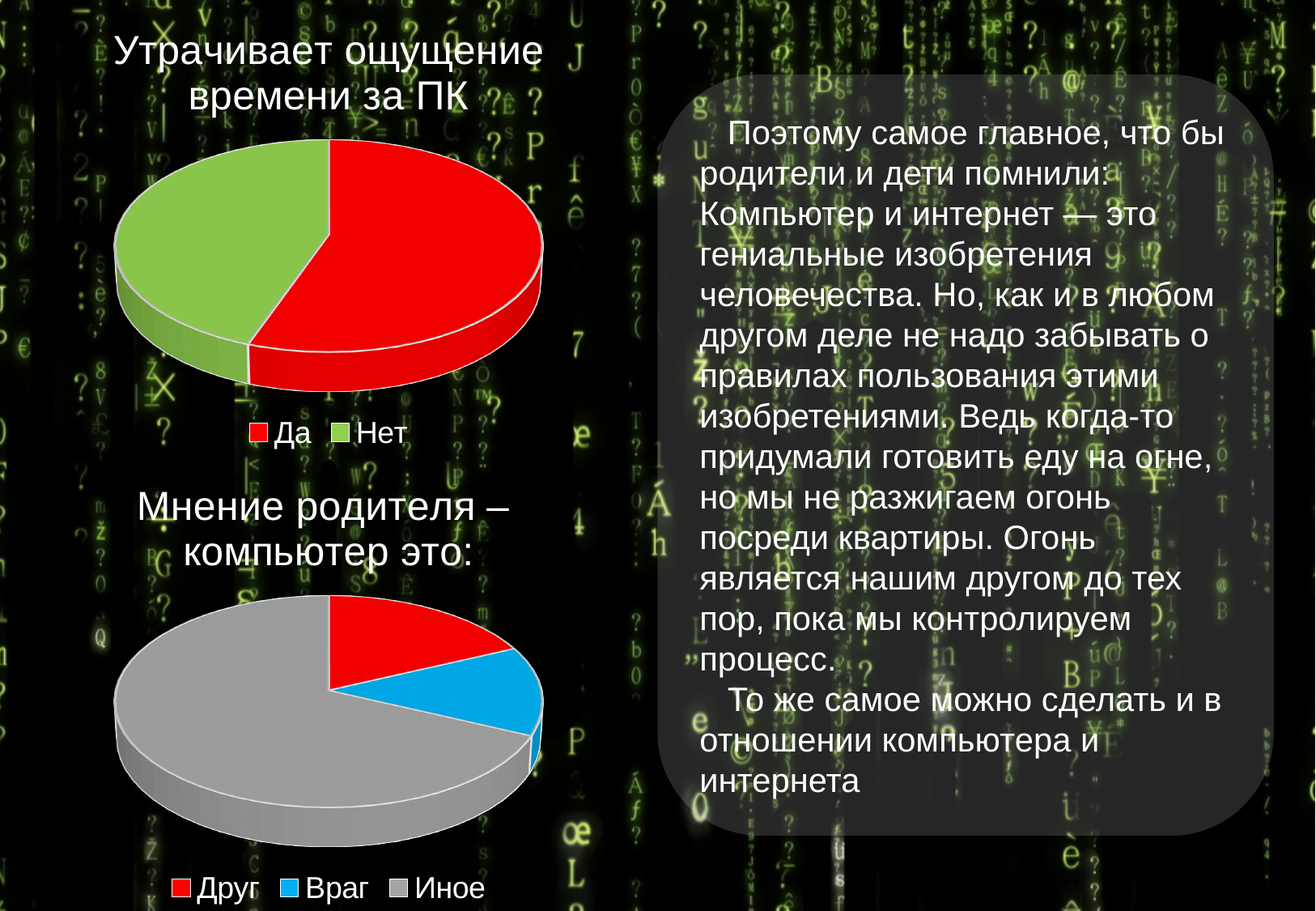
In the top chart "Утрачивает ощущение времени за ПК", which slice is larger: Да or Нет? Да What kind of chart is the bottom chart titled "Мнение родителя – компьютер это:"? Pie chart What kind of chart is the top chart titled "Утрачивает ощущение времени за ПК"? Pie chart In the bottom chart "Мнение родителя – компьютер это:", which category has the smallest slice? Враг In the top chart "Утрачивает ощущение времени за ПК", which category has the largest slice? Да In the top chart "Утрачивает ощущение времени за ПК", which category has the smallest slice? Нет In the bottom chart "Мнение родителя – компьютер это:", what colour is the slice for Враг? Blue In the top chart "Утрачивает ощущение времени за ПК", how many categories does the legend list? 2 In the bottom chart "Мнение родителя – компьютер это:", which slice is larger: Друг or Иное? Иное In the bottom chart "Мнение родителя – компьютер это:", how many categories does the legend list? 3 In the top chart, what colour is the slice for Нет? Green In the bottom chart "Мнение родителя – компьютер это:", which category has the largest slice? Иное